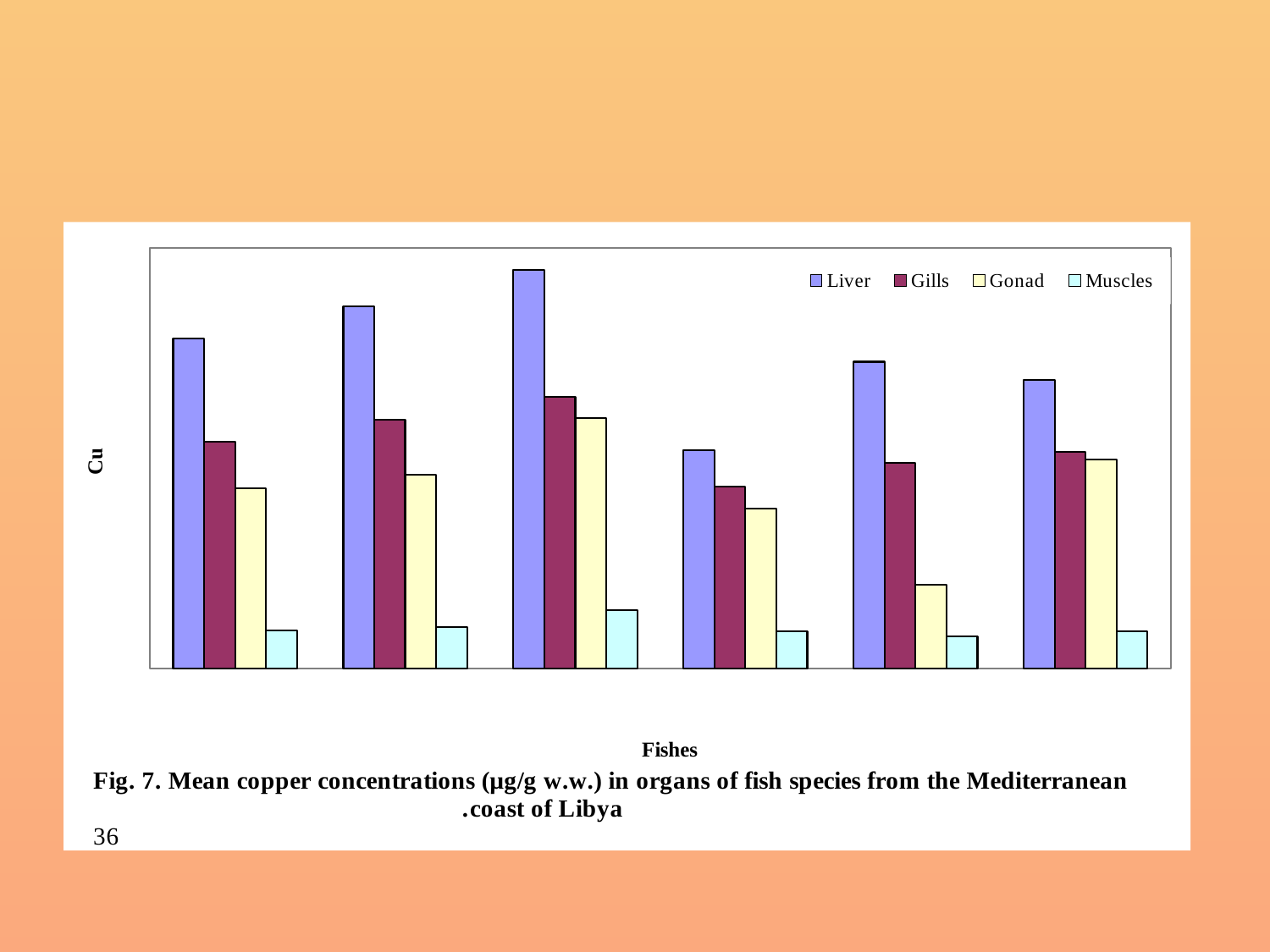
What is the label on the y axis of the chart? Cu Which series has the shortest bar in every group? Muscles What are the four series listed in the legend? Liver, Gills, Gonad, Muscles How many series does the legend list? 4 How many groups of bars (fish species) are plotted along the x axis? 6 What kind of chart is shown on the slide? bar chart In the fifth group of bars from the left, which is larger, Gills or Gonad? Gills Which group of bars from the left has the shortest Liver bar? the fourth In the third group of bars from the left, which is larger, Gills or Gonad? Gills Which series has the tallest bar in every group? Liver Which group of bars from the left has the tallest Liver bar? the third